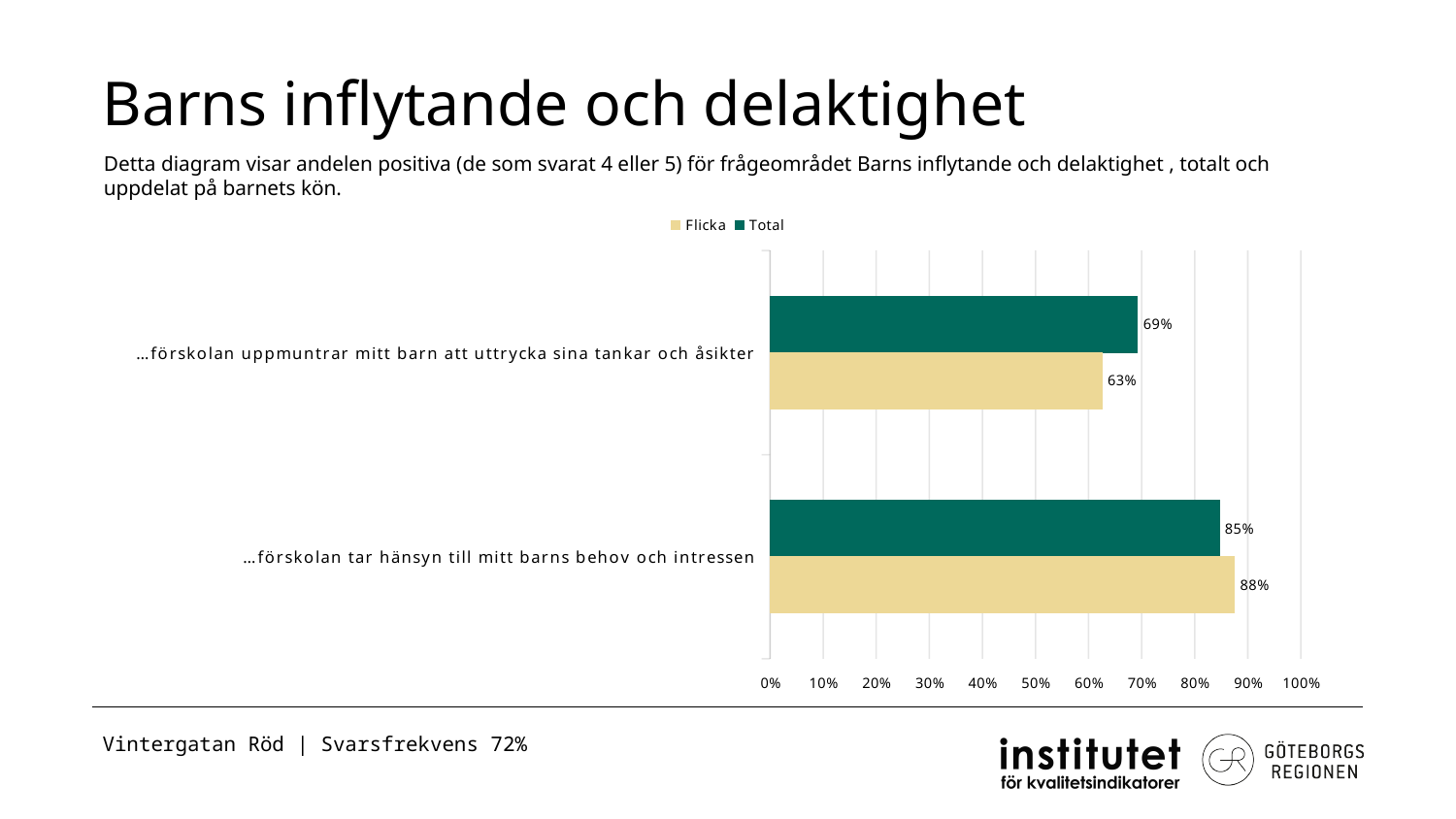
How many series does the legend list? 2 What is the difference between the Flicka and Total values for "…förskolan tar hänsyn till mitt barns behov och intressen"? 3% What is the Total value for "…förskolan uppmuntrar mitt barn att uttrycka sina tankar och åsikter"? 69% For "…förskolan tar hänsyn till mitt barns behov och intressen", which is larger, the Flicka value or the Total value? Flicka What is the difference between the Total and Flicka values for "…förskolan uppmuntrar mitt barn att uttrycka sina tankar och åsikter"? 6% What is the Flicka value for "…förskolan tar hänsyn till mitt barns behov och intressen"? 88% Which category has the lowest Total value? …förskolan uppmuntrar mitt barn att uttrycka sina tankar och åsikter How many categories are shown in the chart? 2 What kind of chart is shown on the slide? Bar chart What is the Total value for "…förskolan tar hänsyn till mitt barns behov och intressen"? 85% What is the Flicka value for "…förskolan uppmuntrar mitt barn att uttrycka sina tankar och åsikter"? 63% Which category has the highest Flicka value? …förskolan tar hänsyn till mitt barns behov och intressen